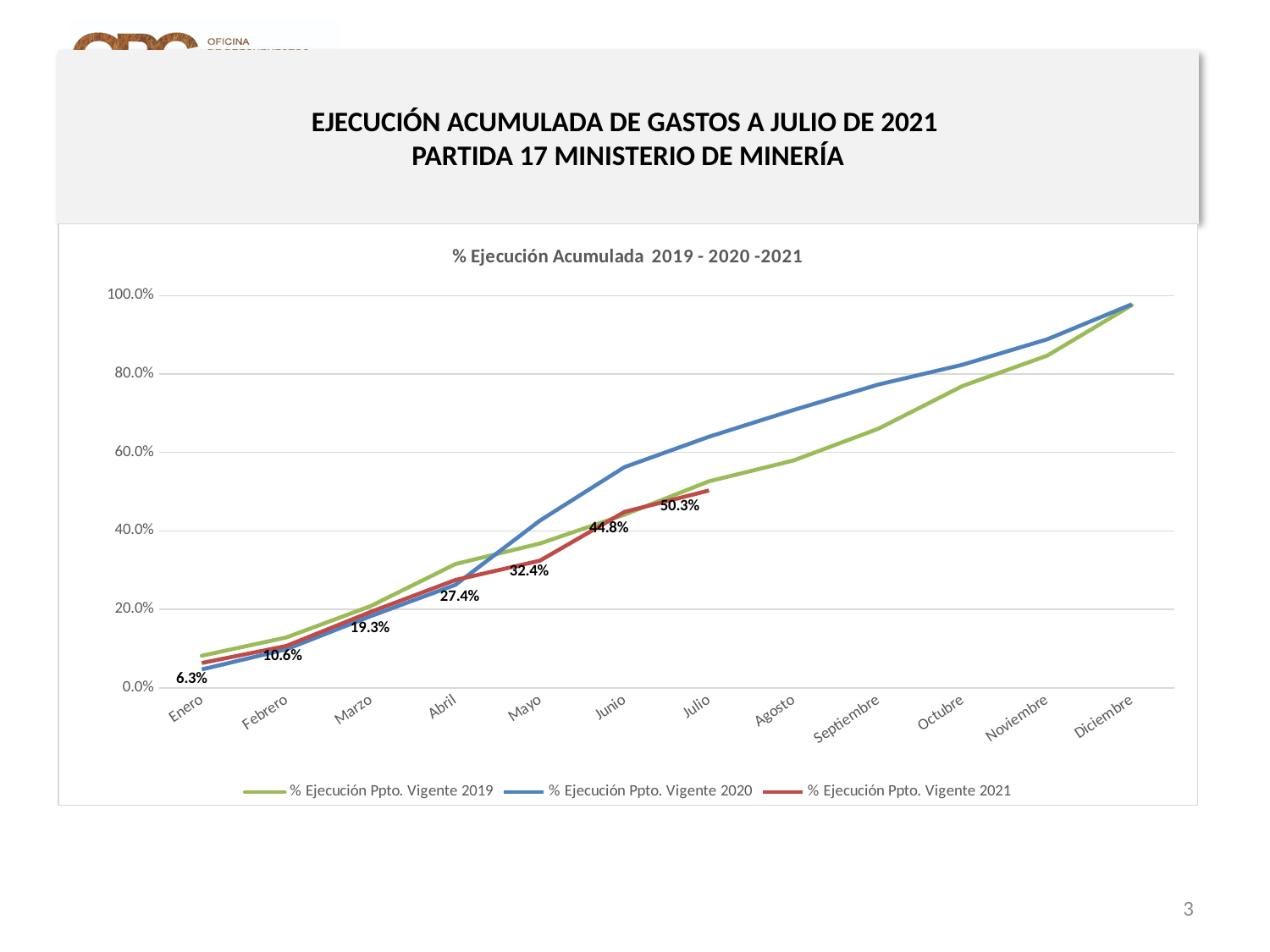
What type of chart is shown on the slide? line chart Which month has the lowest value for % Ejecución Ppto. Vigente 2021? Enero How many series does the legend list? 3 Which month has the highest value for % Ejecución Ppto. Vigente 2021? Julio What is the value for % Ejecución Ppto. Vigente 2021 in Julio? 50.3% What is the difference between the % Ejecución Ppto. Vigente 2021 values for Junio and Mayo? 12.4% Do the values for % Ejecución Ppto. Vigente 2021 rise or fall from Enero to Julio? rise What is the value for % Ejecución Ppto. Vigente 2021 in Enero? 6.3% What is the value for % Ejecución Ppto. Vigente 2021 in Abril? 27.4% Is the value for % Ejecución Ppto. Vigente 2020 in Junio greater or less than 40.0%? greater What is the chart's title? % Ejecución Acumulada 2019 - 2020 -2021 How many months are shown on the x axis? 12